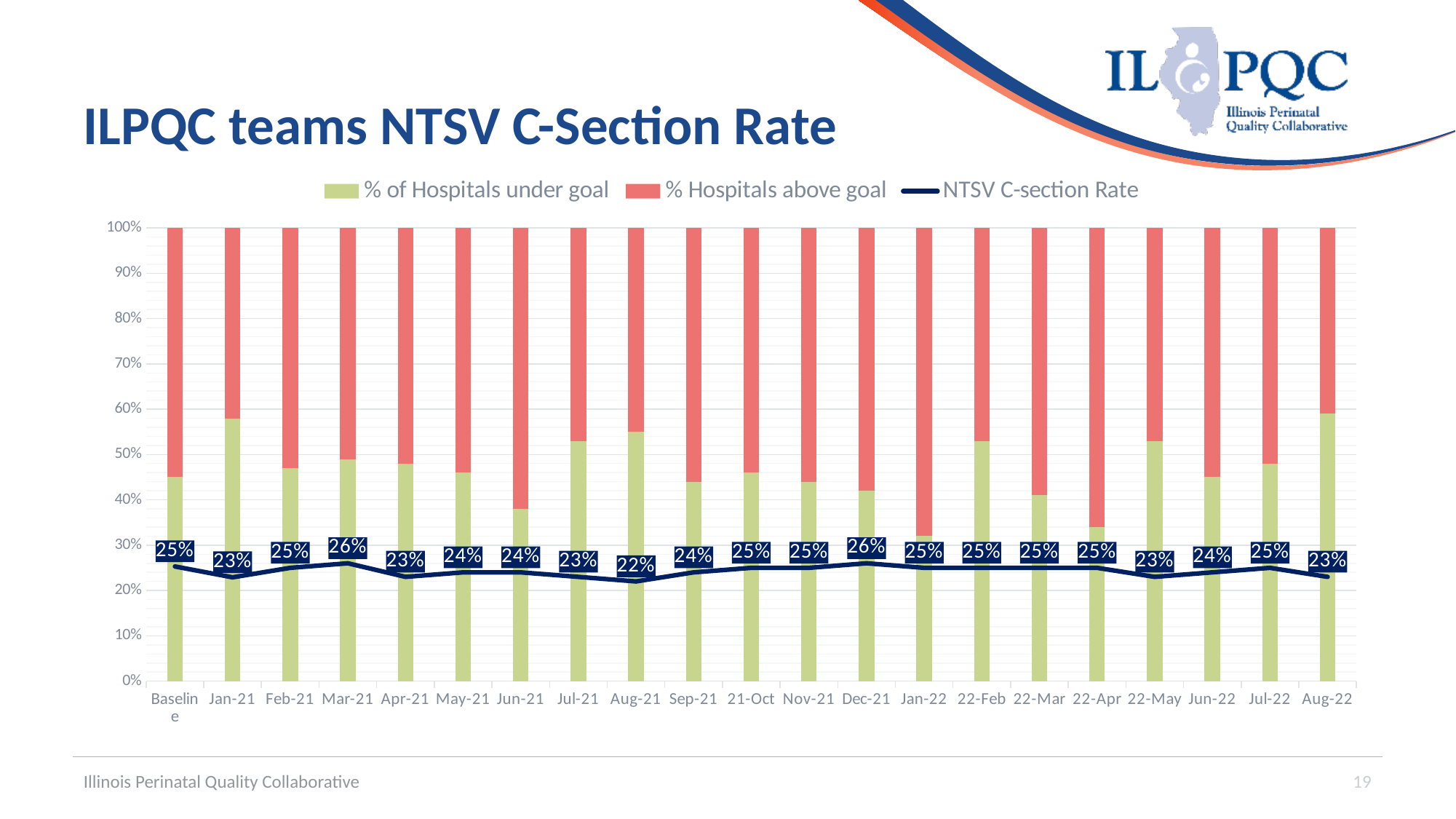
Is the % of Hospitals under goal for Jan-21 greater or less than 50%? greater What is the difference between the NTSV C-section Rate in Mar-21 and in Aug-21? 4 percentage points What is the NTSV C-section Rate for Aug-22? 23% What is the NTSV C-section Rate for Dec-21? 26% How many series does the legend list? 3 Which period has the lowest NTSV C-section Rate? Aug-21 How many time periods are shown on the x axis? 21 Is the % of Hospitals under goal for Jun-21 greater or less than 40%? less What is the NTSV C-section Rate at Baseline? 25% Is the % of Hospitals under goal larger in Jan-21 or in Jun-21? Jan-21 What is the NTSV C-section Rate for Aug-21? 22% Is the NTSV C-section Rate higher in Jan-21 or in Feb-21? Feb-21